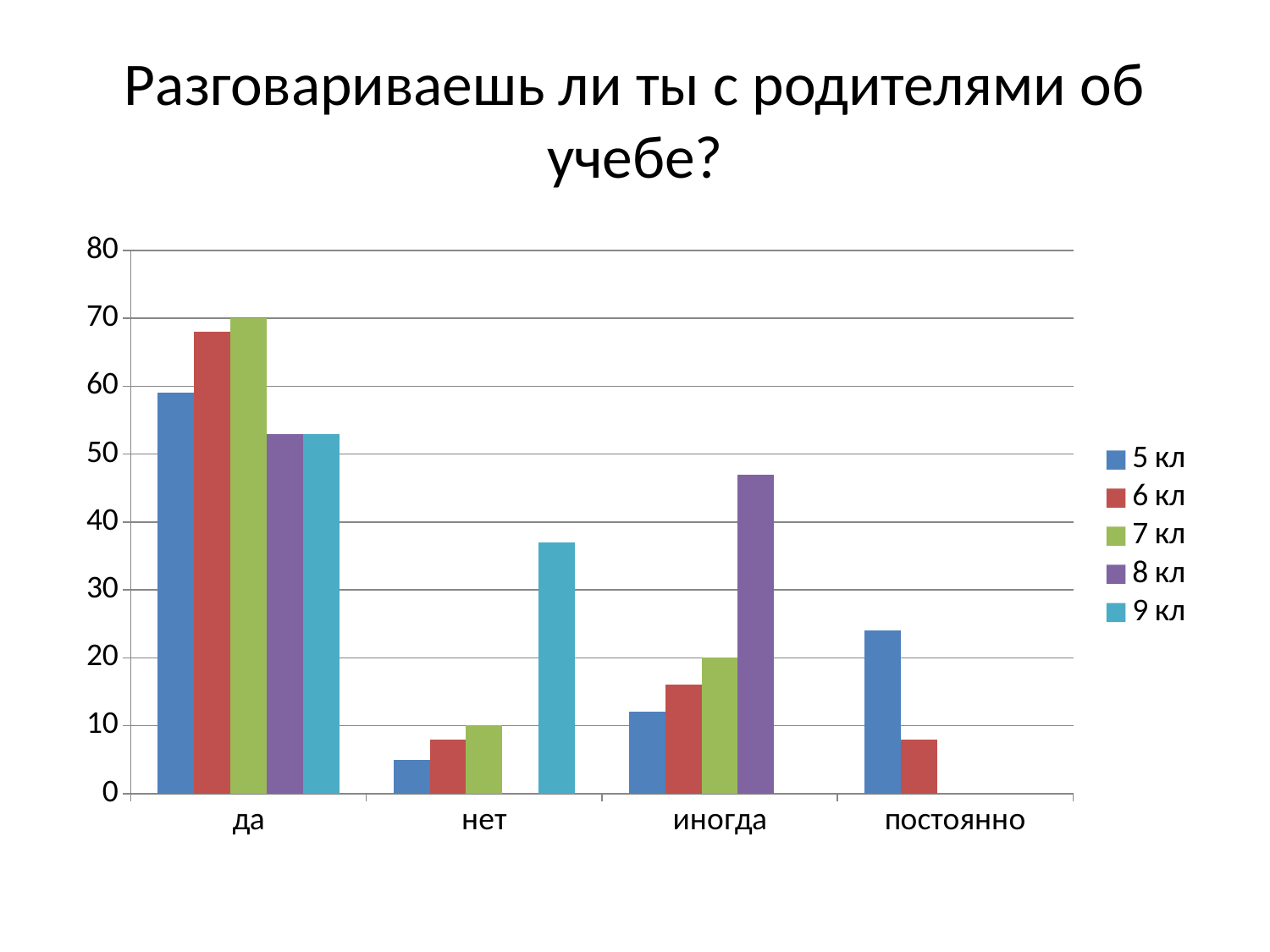
Is the value for 5 кл in the category постоянно greater or less than 20? greater What is the value for 7 кл in the category нет? 10 How many categories are shown on the x axis? 4 What is the value for 7 кл in the category иногда? 20 Is the value for 9 кл in the category нет greater or less than 40? less Which series has the highest value in the category да? 7 кл Which is larger in the category да: the value for 5 кл or the value for 8 кл? 5 кл Which series has the highest value in the category иногда? 8 кл What is the value for 7 кл in the category да? 70 What kind of chart is shown on the slide? bar chart Which series has the highest value in the category нет? 9 кл How many series does the legend list? 5